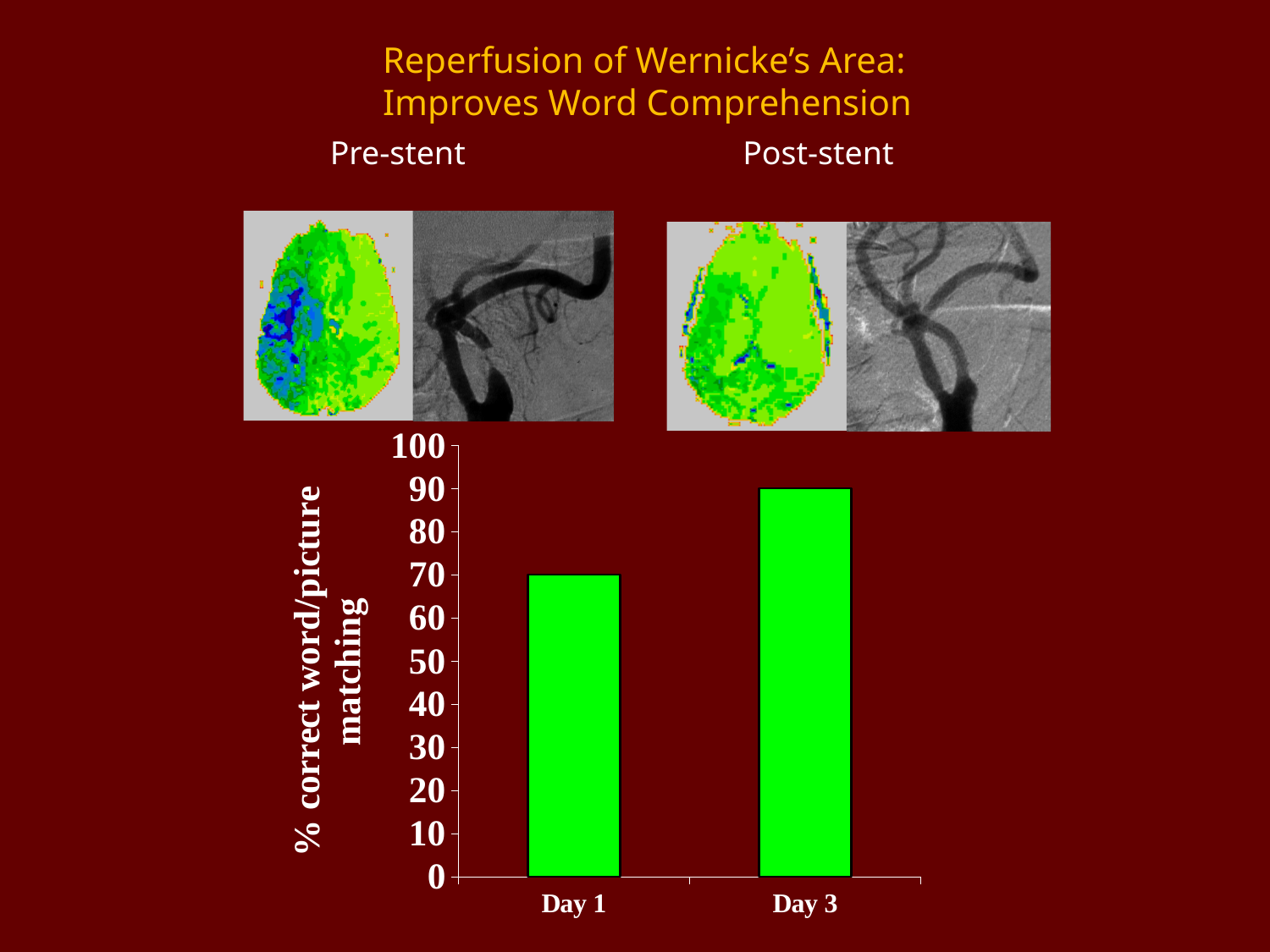
How many bars are plotted in the chart? 2 What is the maximum value shown on the vertical axis of the chart? 100 Which day has the higher % correct word/picture matching? Day 3 By how much does the value for Day 3 exceed the value for Day 1? 20 What is the value for Day 3 in the chart? 90 Which day has the lower % correct word/picture matching? Day 1 What is the label on the vertical axis of the chart? % correct word/picture matching Is the value for Day 1 greater or less than 80? less Does the % correct word/picture matching rise or fall from Day 1 to Day 3? rise Is the value for Day 3 greater or less than 80? greater What kind of chart is shown on the slide? bar chart What is the value for Day 1 in the chart? 70